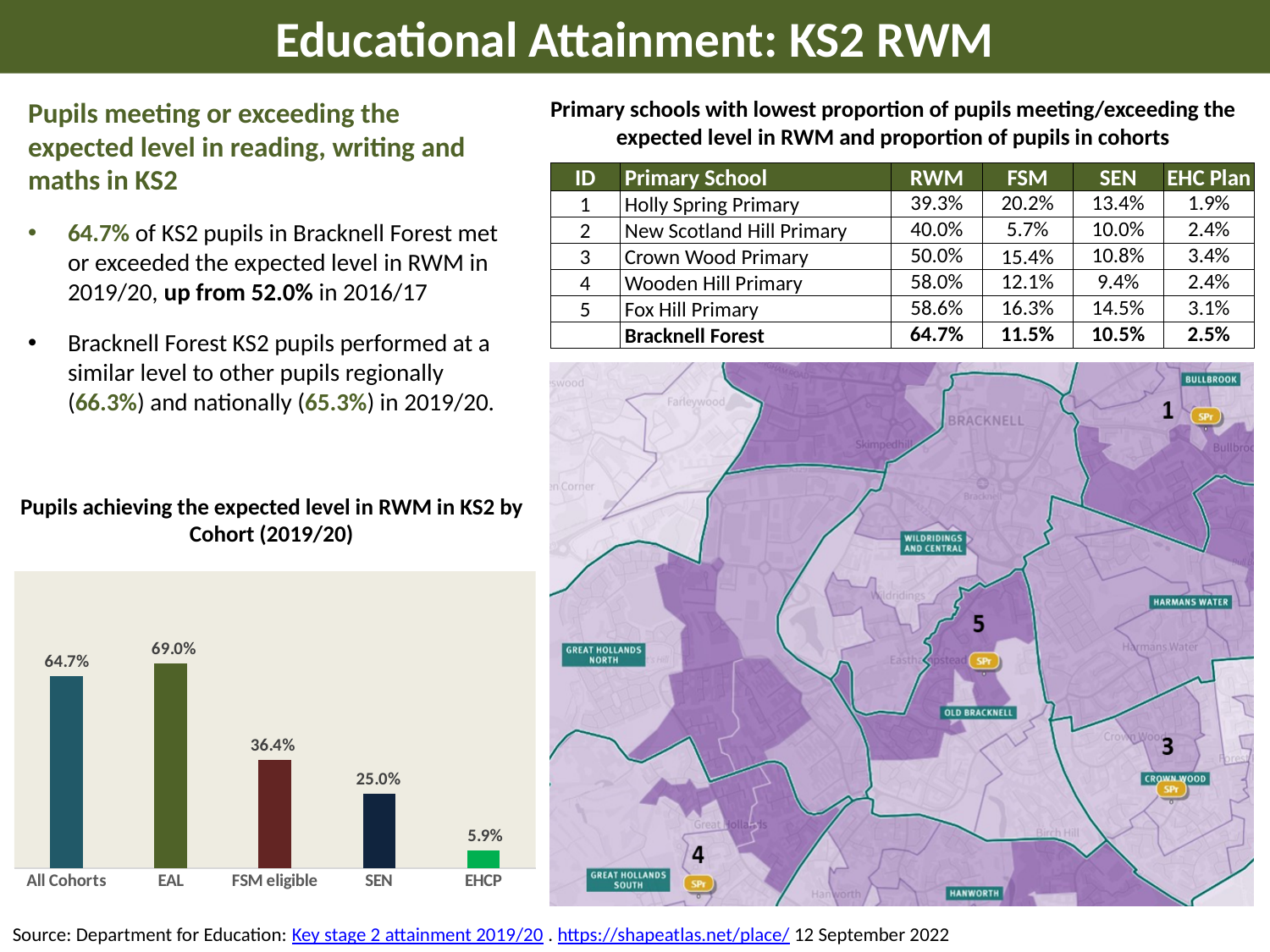
What percentage of EAL pupils achieved the expected level in RWM in KS2 in 2019/20? 69.0% Which is larger, the value for SEN or the value for EHCP? SEN What is the difference in percentage points between the EAL cohort and the All Cohorts value? 4.3 What is the value shown for FSM eligible pupils in the bar chart? 36.4% How many cohorts are shown in the bar chart? 5 What is the value shown for EHCP pupils in the bar chart? 5.9% Which cohort has the lowest proportion of pupils achieving the expected level in RWM? EHCP Which cohort has the highest proportion of pupils achieving the expected level in RWM? EAL What is the difference in percentage points between the FSM eligible and SEN cohorts? 11.4 What is the value shown for SEN pupils in the bar chart? 25.0% What type of chart is used to show pupils achieving the expected level in RWM by cohort? Bar chart What is the title of the bar chart on the slide? Pupils achieving the expected level in RWM in KS2 by Cohort (2019/20)